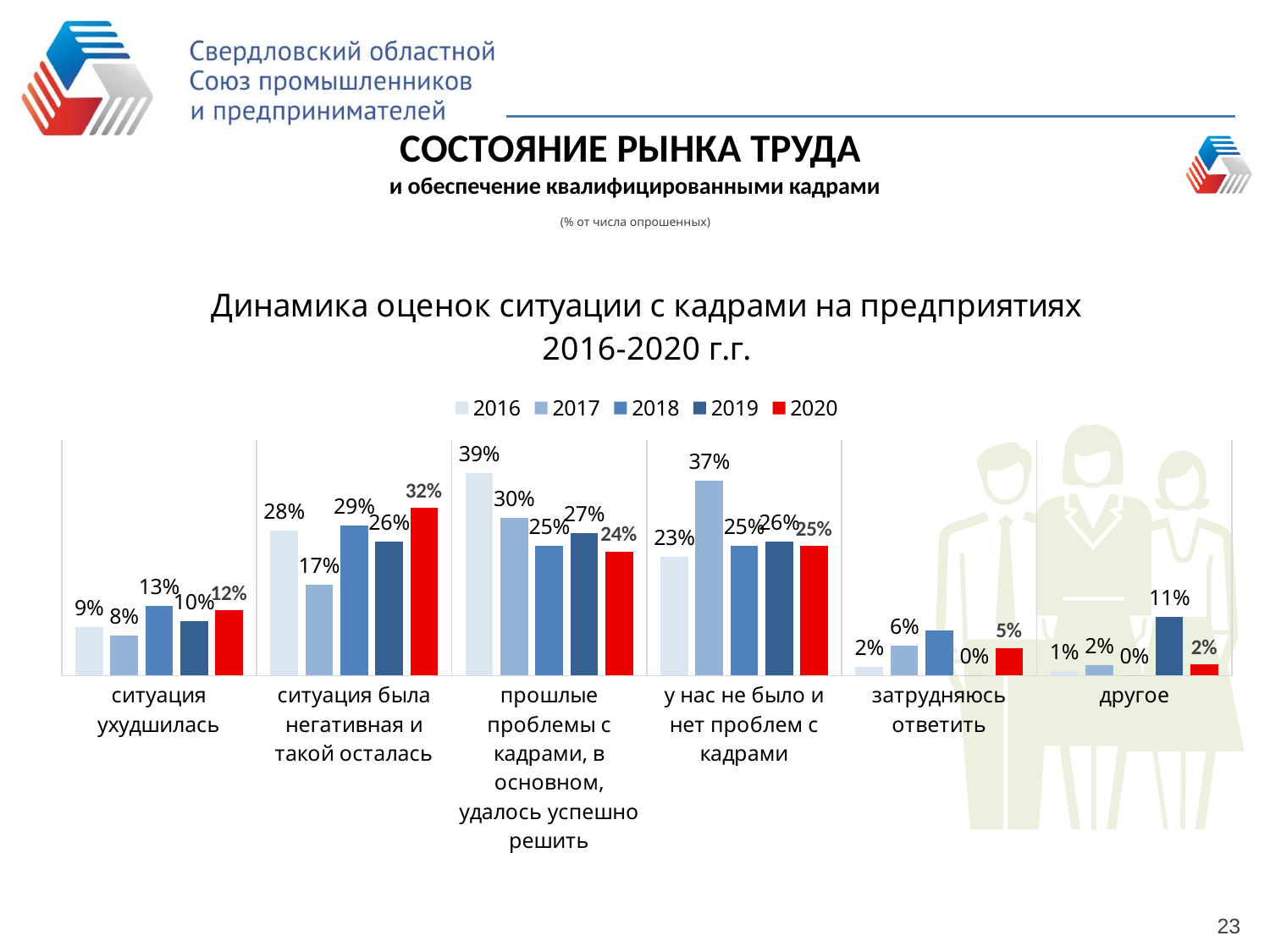
What is the value for 2019 in the category 'другое'? 11% What is the value for 2020 in the category 'ситуация была негативная и такой осталась'? 32% Which year has the highest value in the category 'ситуация ухудшилась'? 2018 What kind of chart is shown on the slide? bar chart Which series is shown in red in the legend? 2020 What is the value for 2016 in the category 'прошлые проблемы с кадрами, в основном, удалось успешно решить'? 39% How many series does the legend list? 5 Which year has the lowest value in the category 'ситуация была негативная и такой осталась'? 2017 Which is larger in the category 'другое': the value for 2019 or the value for 2020? 2019 How many categories are shown on the x axis? 6 What is the difference between the 2016 and 2020 values in the category 'прошлые проблемы с кадрами, в основном, удалось успешно решить'? 15% What is the value for 2017 in the category 'у нас не было и нет проблем с кадрами'? 37%